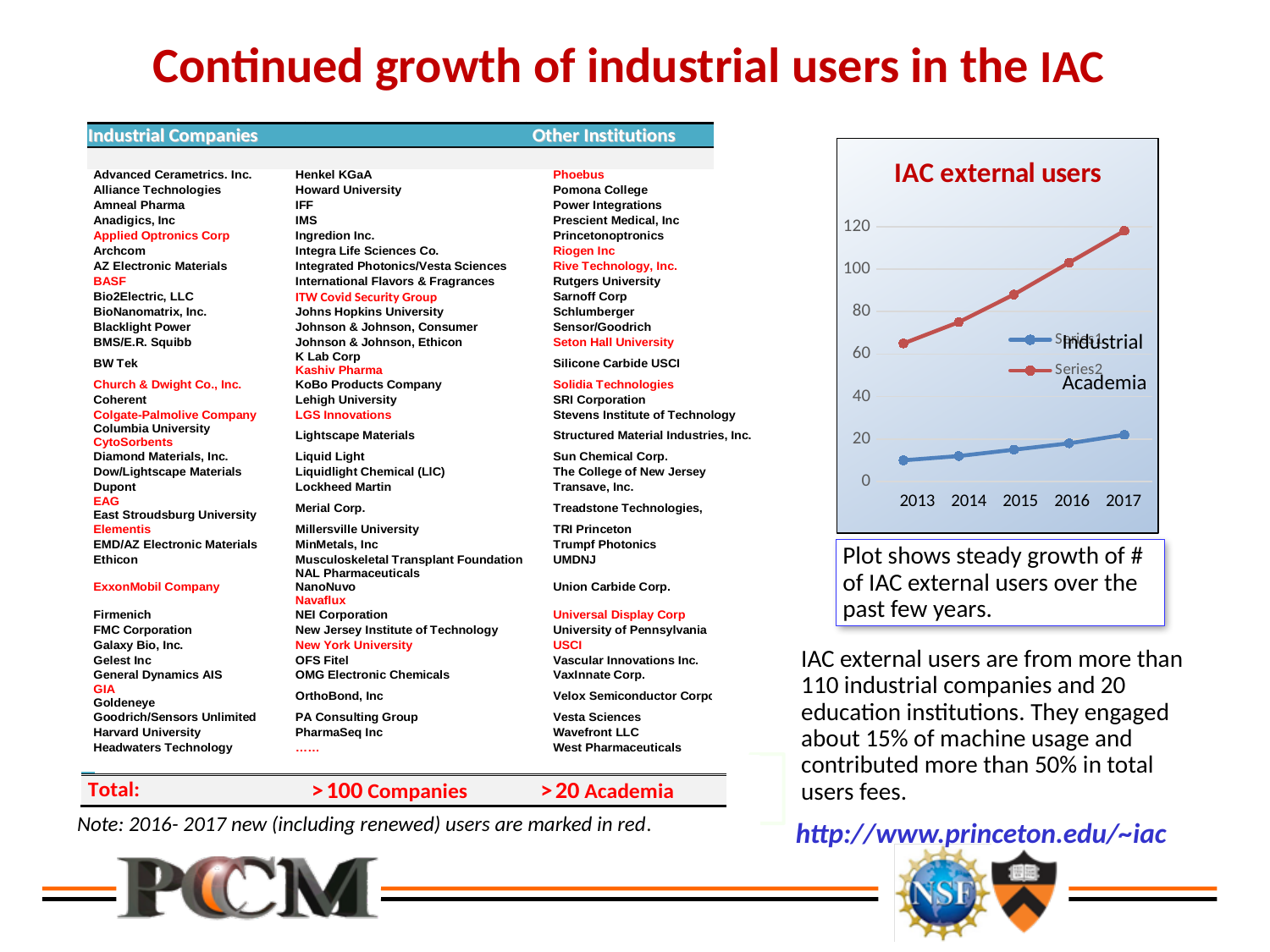
What kind of chart is shown on the slide? line chart In which year is the blue (Series1) line at its lowest? 2013 In which year is the red (Series2) line at its highest? 2017 Do the values of the blue (Series1) line rise or fall from 2013 to 2017? rise What is the title of the chart? IAC external users Do the values of the red (Series2) line rise or fall from 2013 to 2017? rise How many series does the chart's legend list? 2 Is the value of the red (Series2) line in 2014 greater or less than 80? less Is the value of the blue (Series1) line in 2013 greater or less than 20? less In 2017, which line has the larger value, the red (Series2) line or the blue (Series1) line? the red (Series2) line Is the value of the red (Series2) line in 2017 greater or less than 100? greater How many years are shown along the x axis of the chart? 5